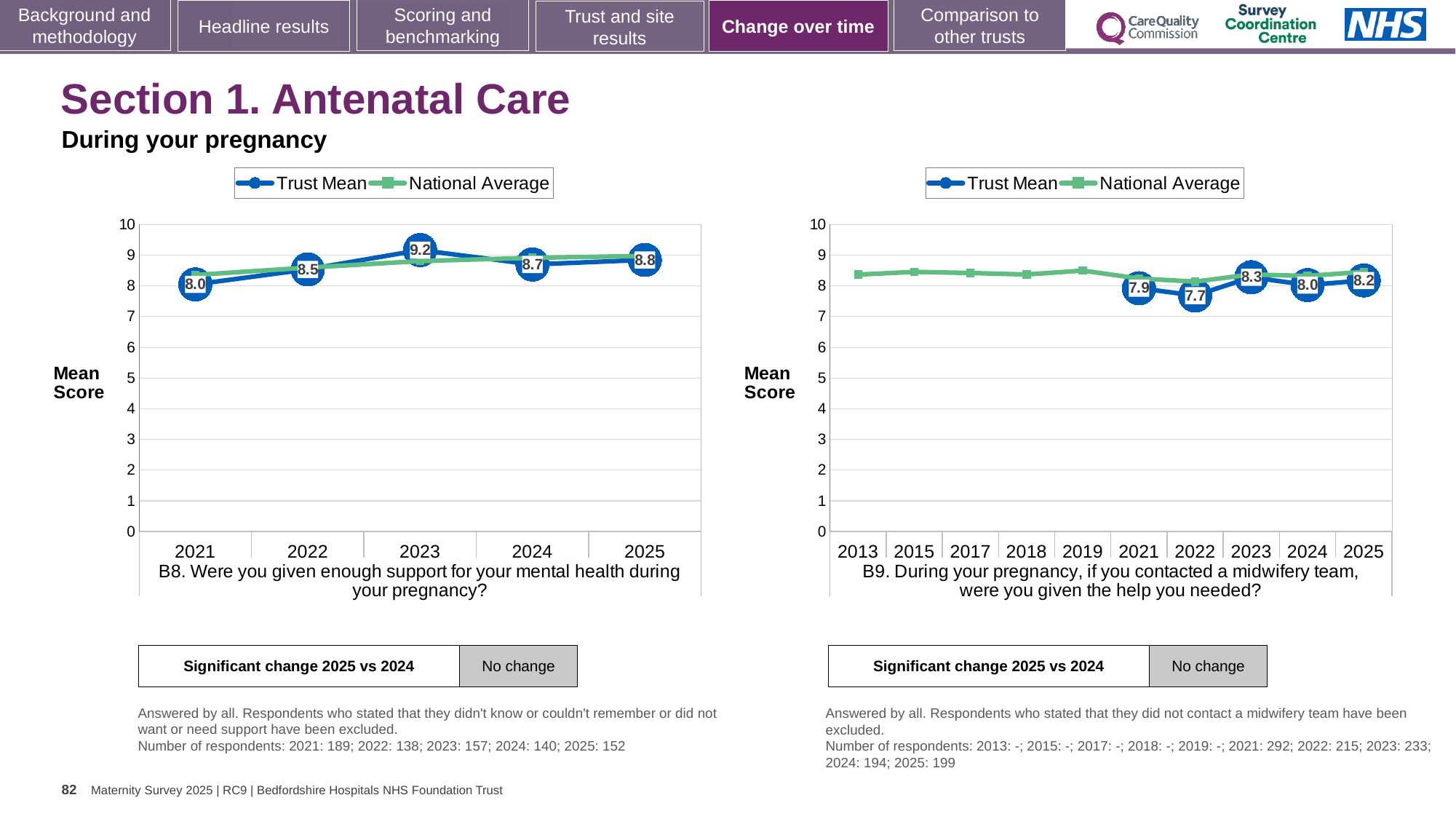
In the right chart (B9), is the Trust Mean higher in 2023 or in 2024? 2023 In the left chart (B8), which year has the highest Trust Mean? 2023 In the right chart (B9), which year has the lowest Trust Mean? 2022 In the left chart (B8), what is the Trust Mean for 2023? 9.2 In the left chart (B8), what is the difference between the Trust Mean in 2023 and in 2021? 1.2 In the right chart (B9), what is the Trust Mean for 2025? 8.2 What type of chart is the left chart (B8)? Line chart In the left chart (B8), what is the Trust Mean for 2021? 8.0 In the right chart (B9), how many years are shown on the x axis? 10 In the left chart (B8), which year has the lowest Trust Mean? 2021 How many series does the legend of the left chart (B8) list? 2 In the right chart (B9), what is the Trust Mean for 2022? 7.7